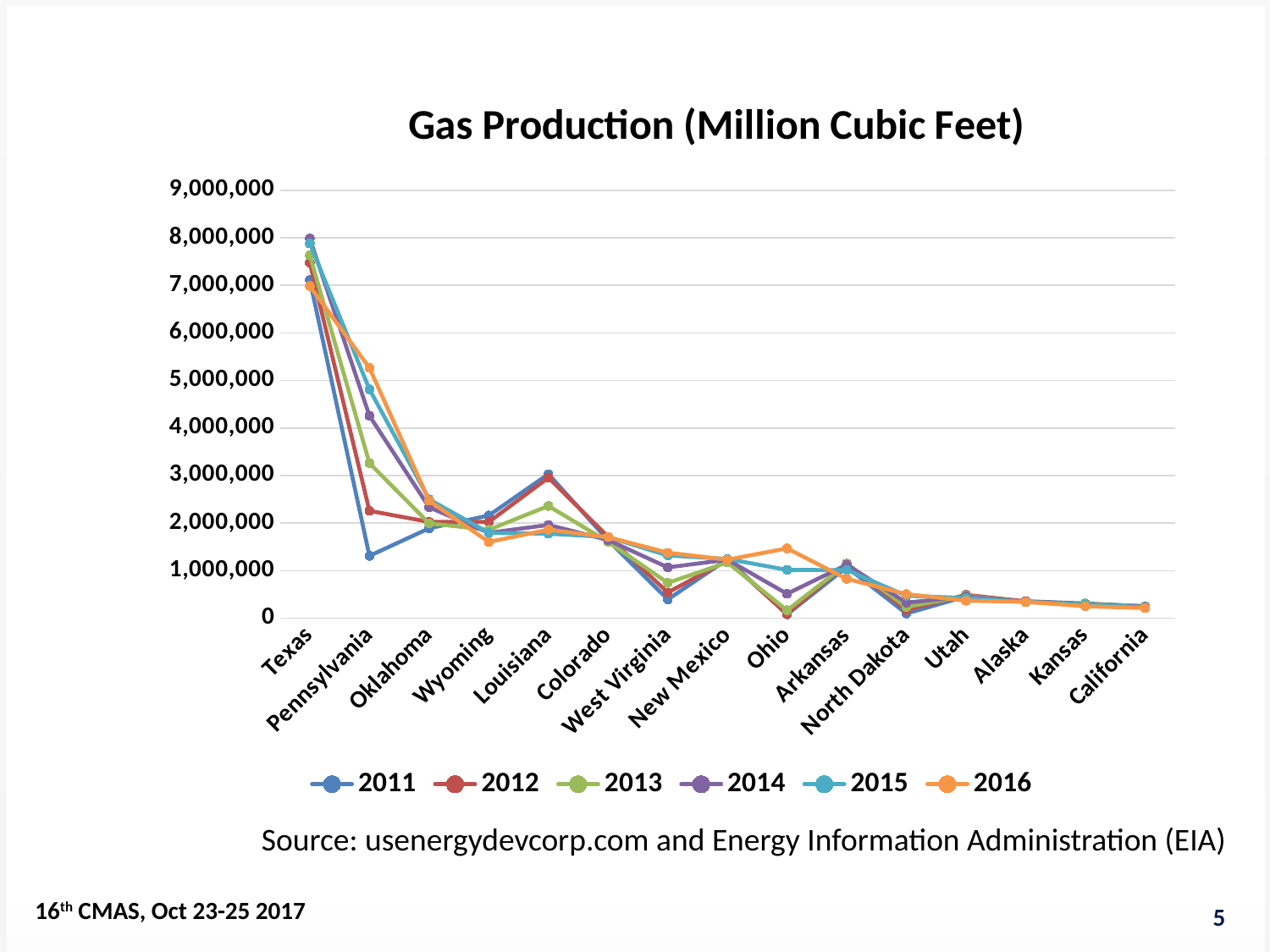
Is the 2012 value for Ohio greater or less than 1,000,000? less How many states are shown along the x axis? 15 Is the 2011 value for Pennsylvania greater or less than 2,000,000? less For Louisiana, which is larger: the 2011 value or the 2016 value? 2011 For Pennsylvania, which is larger: the 2011 value or the 2016 value? 2016 How many series does the legend list? 6 Which state has the highest gas production for 2016? Texas Do the values for Pennsylvania rise or fall from 2011 to 2016? rise Is the 2016 value for Pennsylvania greater or less than 5,000,000? greater What kind of chart is shown on the slide? line chart What is the title of the chart? Gas Production (Million Cubic Feet)